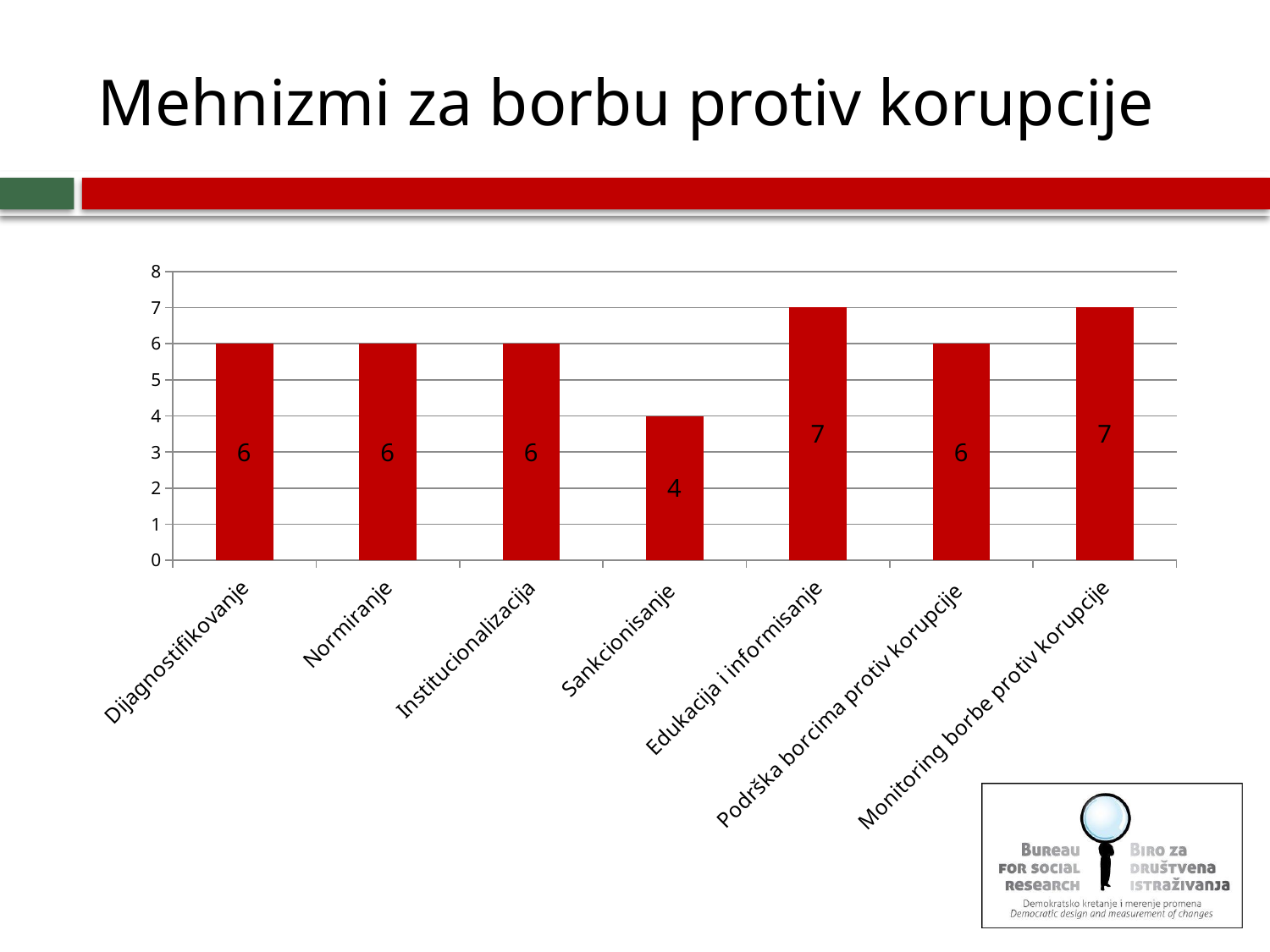
What is the value for Normiranje? 6 What is the difference between the values for Monitoring borbe protiv korupcije and Institucionalizacija? 1 What is the value for Sankcionisanje? 4 What is the difference between the values for Edukacija i informisanje and Sankcionisanje? 3 What kind of chart is shown on the slide? bar chart How many categories are shown on the x axis? 7 Which category has the lowest value? Sankcionisanje Which is larger, the value for Dijagnostifikovanje or the value for Sankcionisanje? Dijagnostifikovanje What is the title of the slide? Mehnizmi za borbu protiv korupcije What is the value for Edukacija i informisanje? 7 Is the value for Sankcionisanje greater or less than 5? less What is the value for Podrška borcima protiv korupcije? 6